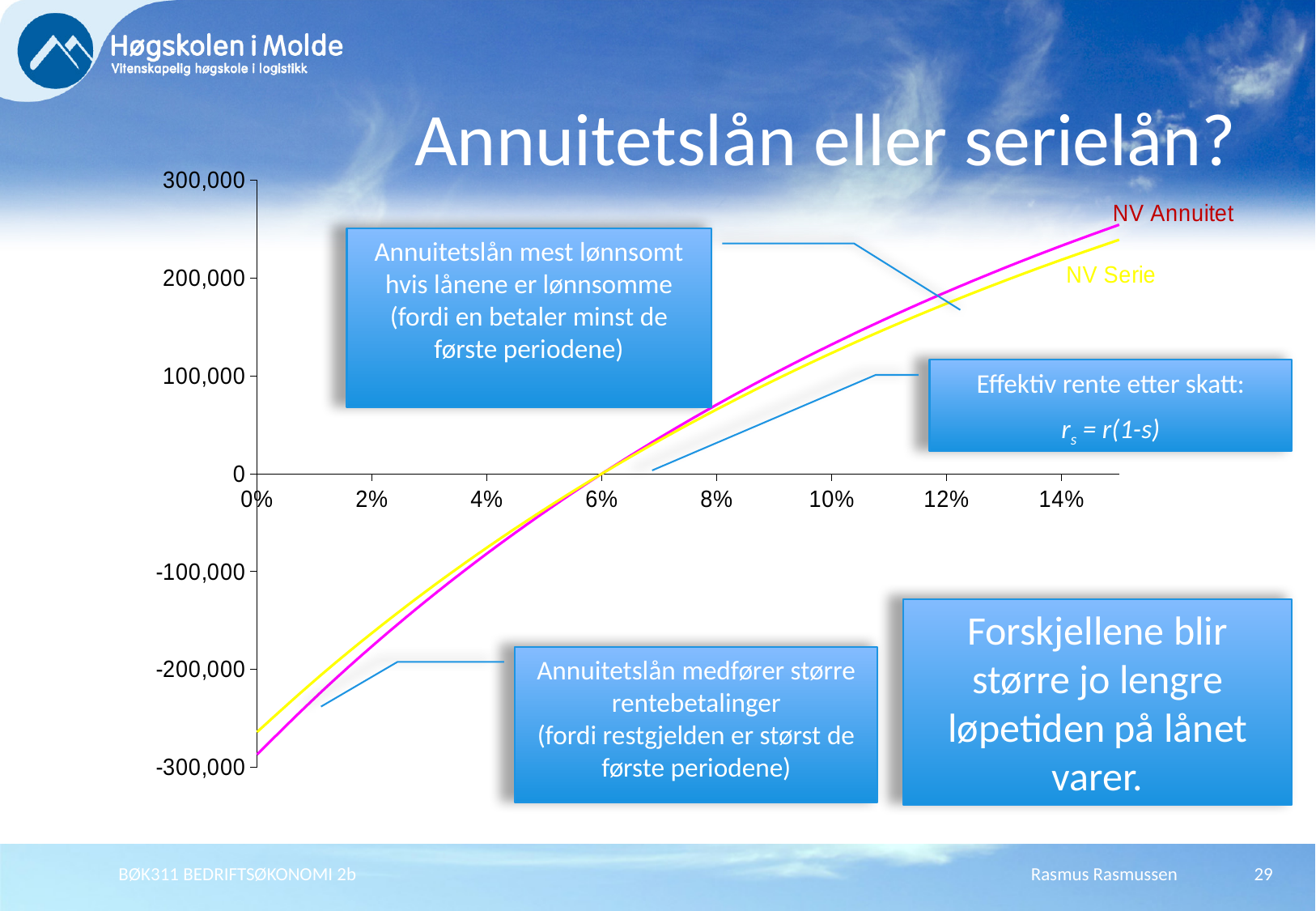
At 14%, which series has the higher value, NV Annuitet or NV Serie? NV Annuitet Which colour is the NV Serie line drawn in? yellow At 0%, which series has the higher value, NV Annuitet or NV Serie? NV Serie What kind of chart is shown on the slide? line chart Is the value of NV Annuitet at 14% greater or less than 200,000? greater Is the value of NV Serie at 0% greater or less than -200,000? less Is the value of NV Serie at 10% greater or less than 100,000? greater Do the NV Serie values rise or fall as the interest rate on the x axis increases? rise How many series are plotted in the chart? 2 What are the names of the two series in the chart? NV Annuitet and NV Serie Do the NV Annuitet values rise or fall as the interest rate on the x axis increases? rise